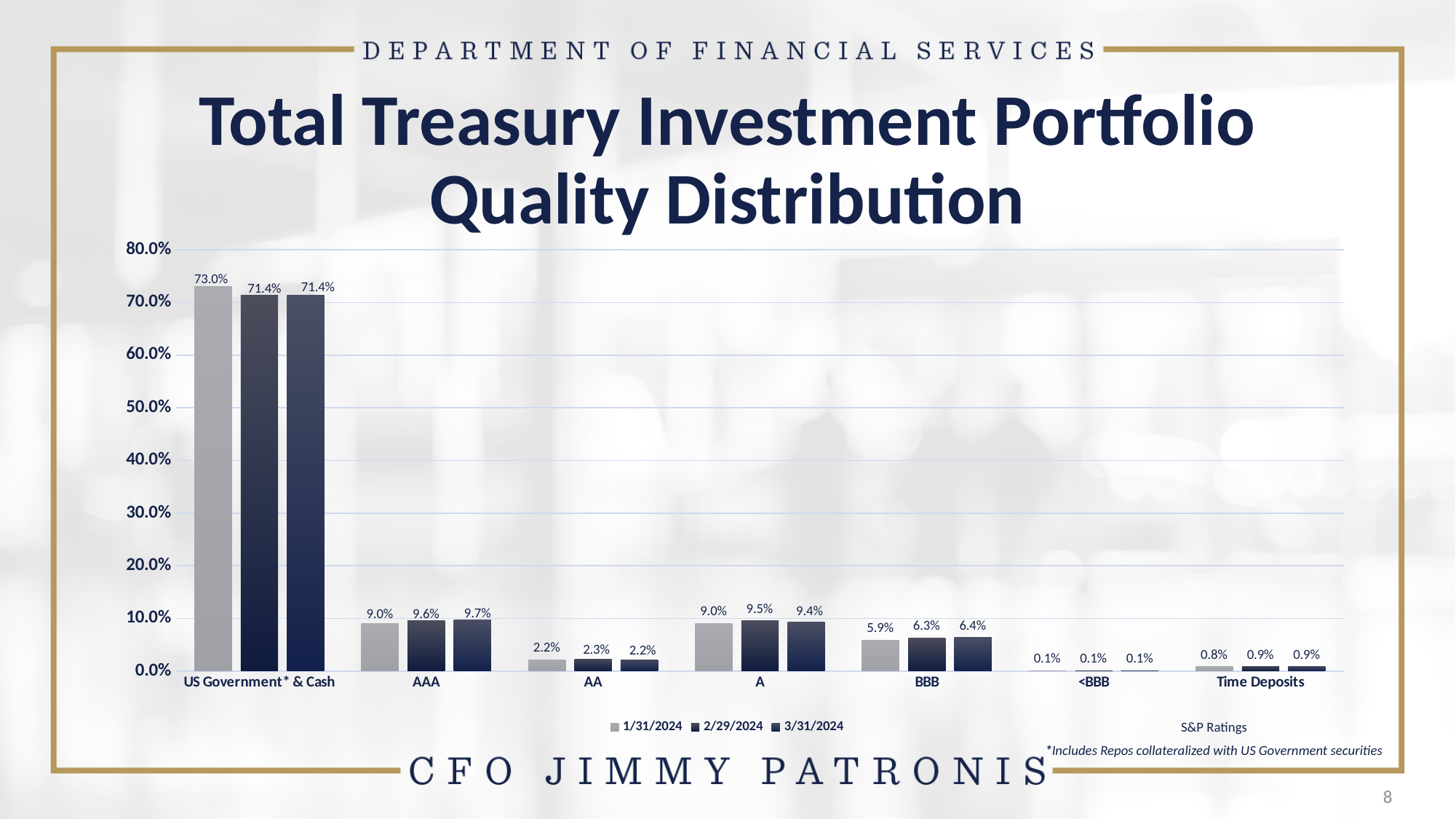
What is the value for Time Deposits on 3/31/2024? 0.9% How many rating categories are shown on the x axis? 7 Which category has the lowest value on 1/31/2024? <BBB What is the value for US Government* & Cash on 1/31/2024? 73.0% What is the title of the chart? Total Treasury Investment Portfolio Quality Distribution What is the value for AAA on 3/31/2024? 9.7% What is the difference between the US Government* & Cash values on 1/31/2024 and 3/31/2024? 1.6% What kind of chart is shown on the slide? Bar chart Which category has the highest value on 3/31/2024? US Government* & Cash What is the value for BBB on 2/29/2024? 6.3% Which is larger on 2/29/2024: AAA or A? AAA How many series does the legend list? 3